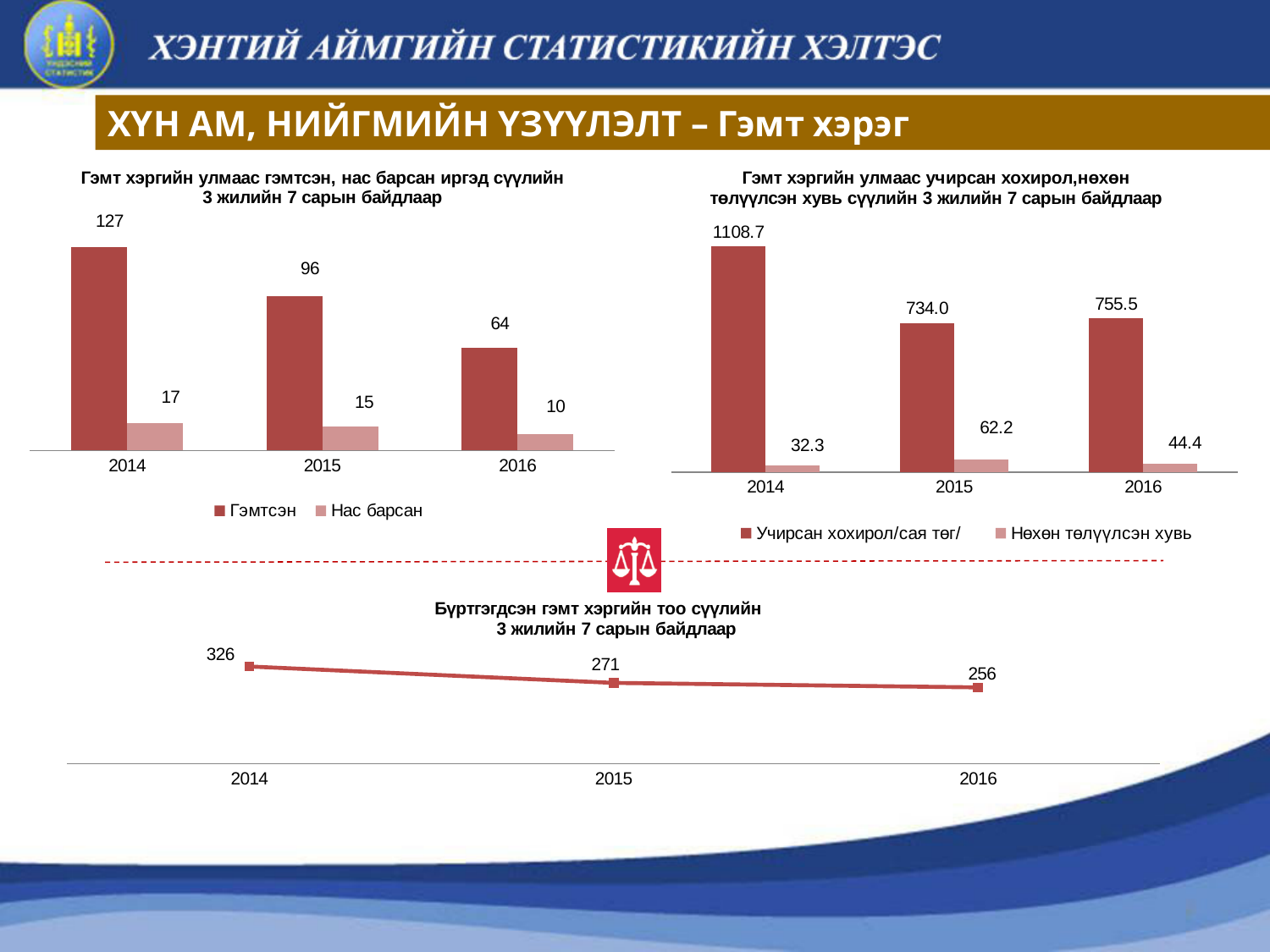
In the top-left chart (Гэмт хэргийн улмаас гэмтсэн, нас барсан иргэд), what is the value for Гэмтсэн in 2014? 127 In the top-right chart (Гэмт хэргийн улмаас учирсан хохирол), what is the value for Учирсан хохирол/сая төг/ in 2014? 1108.7 In the top-left chart (Гэмт хэргийн улмаас гэмтсэн, нас барсан иргэд), what is the value for Нас барсан in 2016? 10 In the top-left chart (Гэмт хэргийн улмаас гэмтсэн, нас барсан иргэд), what is the difference between the Гэмтсэн values for 2015 and 2016? 32 What kind of chart is the bottom chart (Бүртгэгдсэн гэмт хэргийн тоо)? line chart In the top-right chart (Гэмт хэргийн улмаас учирсан хохирол), what is the value for Нөхөн төлүүлсэн хувь in 2015? 62.2 In the bottom chart (Бүртгэгдсэн гэмт хэргийн тоо), do the values rise or fall from 2014 to 2016? fall In the top-left chart (Гэмт хэргийн улмаас гэмтсэн, нас барсан иргэд), which year has the highest Гэмтсэн value? 2014 In the bottom chart (Бүртгэгдсэн гэмт хэргийн тоо), what is the value for 2015? 271 In the top-left chart (Гэмт хэргийн улмаас гэмтсэн, нас барсан иргэд), how many series does the legend list? 2 In the top-right chart (Гэмт хэргийн улмаас учирсан хохирол), is the Нөхөн төлүүлсэн хувь value larger in 2014 or in 2016? 2016 In the top-right chart (Гэмт хэргийн улмаас учирсан хохирол), which year has the lowest Учирсан хохирол/сая төг/ value? 2015